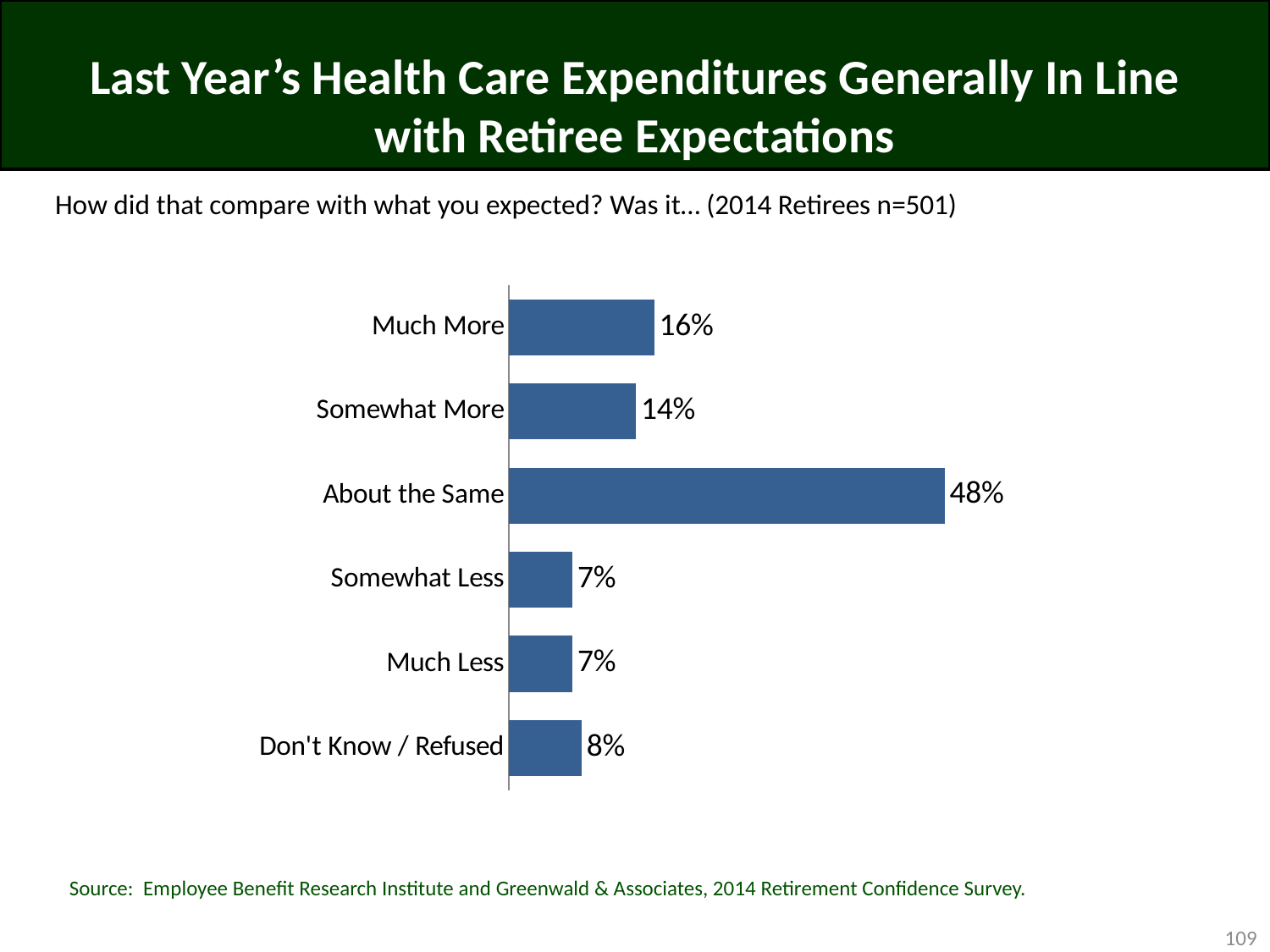
What is the value for Much More? 16% What is the difference between the values for Much More and Somewhat More? 2% Which two categories share the same value of 7%? Somewhat Less and Much Less What kind of chart is shown on the slide? Bar chart Which category has the highest value? About the Same Which is larger, the value for Somewhat More or the value for Don't Know / Refused? Somewhat More What is the value for Somewhat More? 14% What is the sample size of 2014 retirees stated in the question text above the chart? n=501 What is the value for Don't Know / Refused? 8% What is the difference between the values for About the Same and Much More? 32% What percentage of retirees said their health care expenditures were about the same as expected? 48% How many categories are shown in the chart? 6